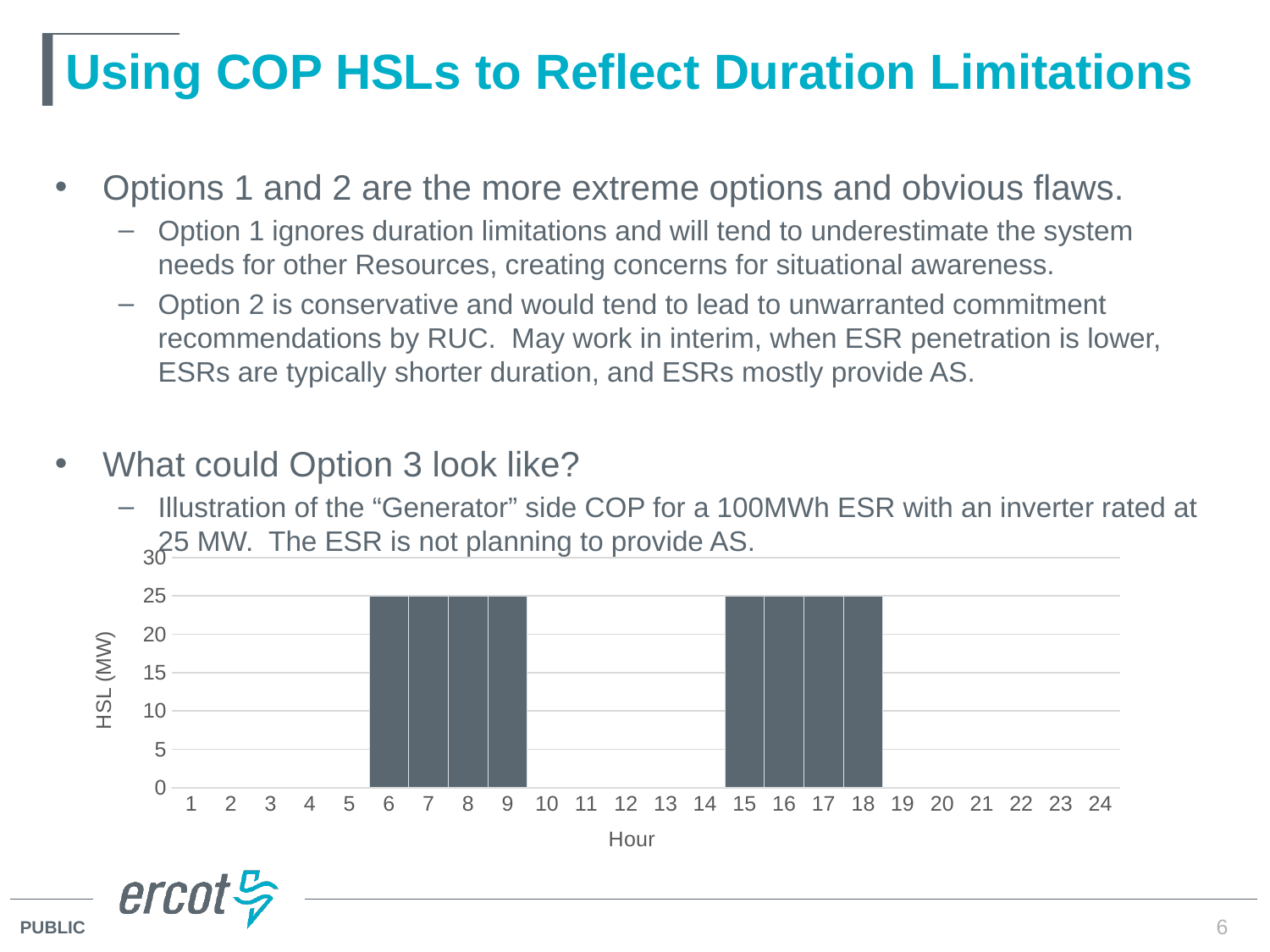
What is the label of the x axis of the chart? Hour What is the HSL (MW) value for hour 17? 25 What is the HSL (MW) value for hour 12? 0 What is the label of the y axis of the chart? HSL (MW) How many hours are shown on the x axis of the chart? 24 What kind of chart is shown on the slide? bar chart What is the HSL (MW) value for hour 6? 25 Is the value for hour 8 greater or less than 20? greater What is the difference between the HSL value for hour 15 and the HSL value for hour 20? 25 How many hours have a non-zero HSL bar in the chart? 8 What is the HSL (MW) value for hour 1? 0 Which has a larger HSL value, hour 9 or hour 13? hour 9